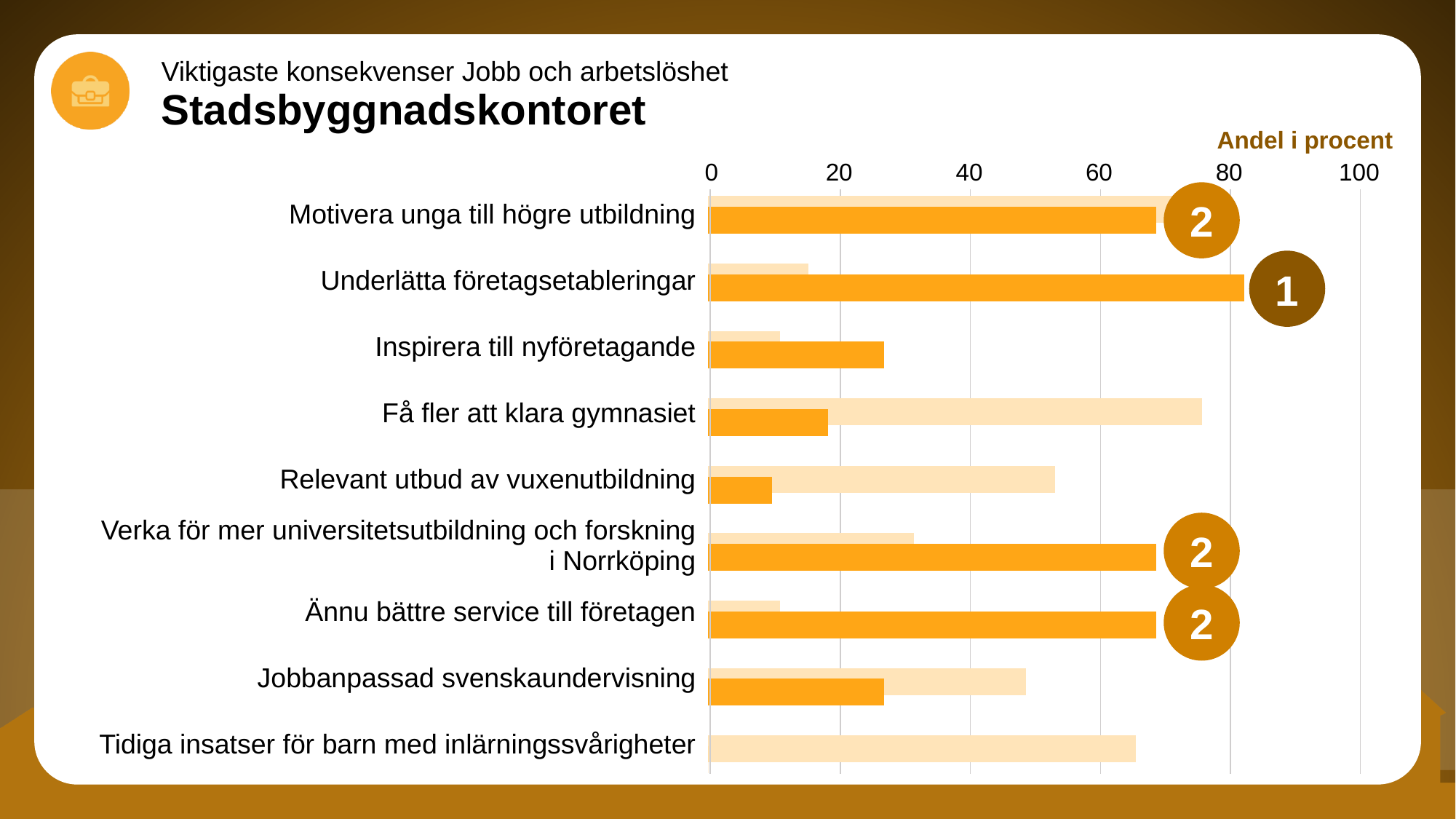
Is the dark orange bar for Inspirera till nyföretagande greater or less than 40? less What kind of chart is shown on the slide? bar chart Is the dark orange bar for Underlätta företagsetableringar greater or less than 60? greater Is the dark orange bar for Få fler att klara gymnasiet greater or less than 40? less Which has the longer light orange bar: Få fler att klara gymnasiet or Relevant utbud av vuxenutbildning? Få fler att klara gymnasiet How many categories are listed on the vertical axis of the chart? 9 Which has the longer dark orange bar: Motivera unga till högre utbildning or Inspirera till nyföretagande? Motivera unga till högre utbildning Which category is marked with the rank badge "1"? Underlätta företagsetableringar What is the label shown above the horizontal axis of the chart? Andel i procent Which category has the longest dark orange bar? Underlätta företagsetableringar